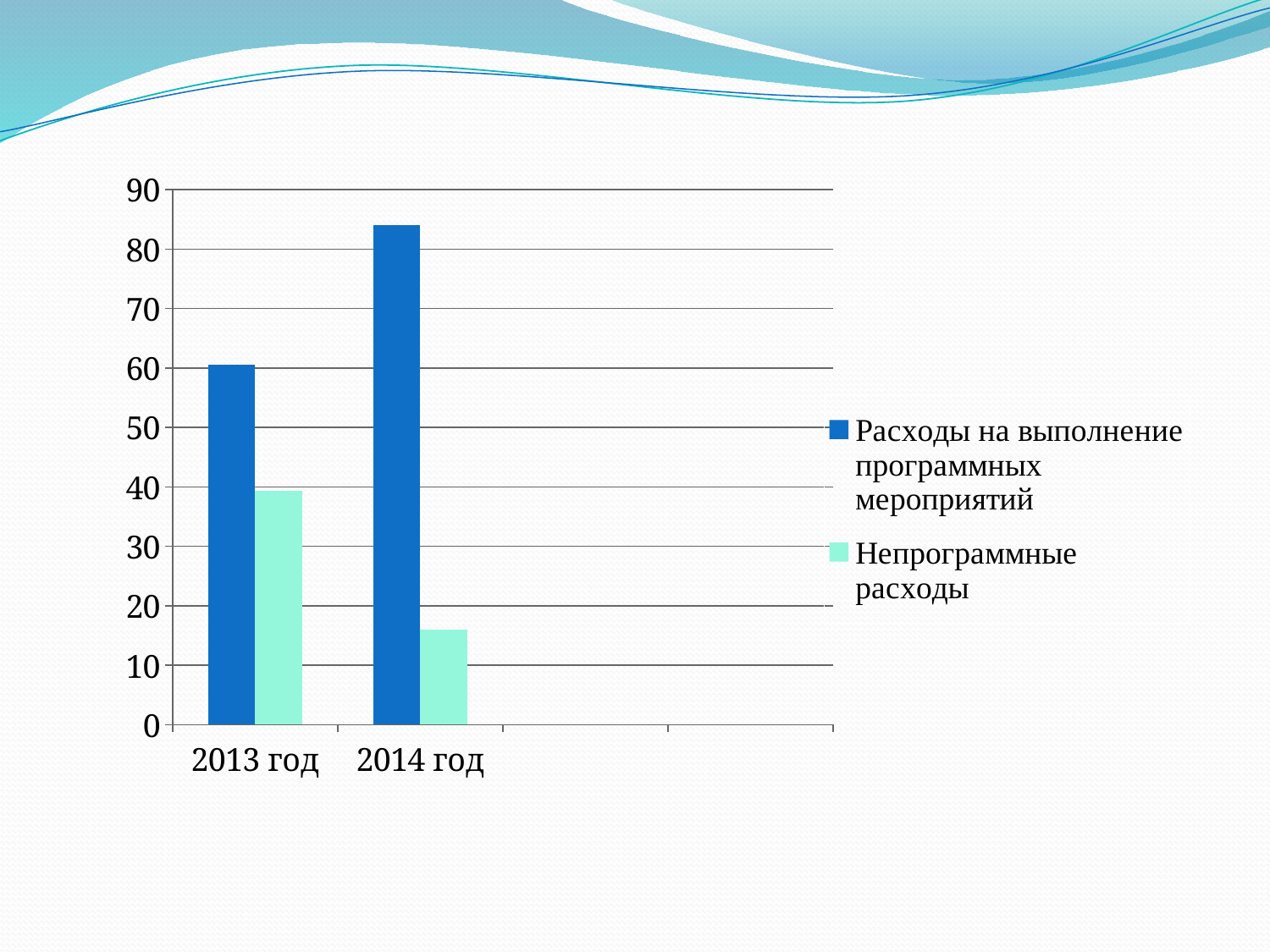
Which year has the higher value for Расходы на выполнение программных мероприятий, 2013 год or 2014 год? 2014 год How many series does the chart's legend list? 2 Is the value for Непрограммные расходы in 2014 год greater or less than 20? less How many categories are shown on the x axis of the chart? 2 Is the value for Расходы на выполнение программных мероприятий in 2013 год greater or less than 50? greater Which bar is the tallest in the chart? Расходы на выполнение программных мероприятий in 2014 год What kind of chart is shown on the slide? bar chart What colour are the bars for Непрограммные расходы in the chart? light green Is the value for Непрограммные расходы in 2013 год greater or less than 30? greater Which year has the lower value for Непрограммные расходы? 2014 год Does the value for Непрограммные расходы rise or fall from 2013 год to 2014 год? fall